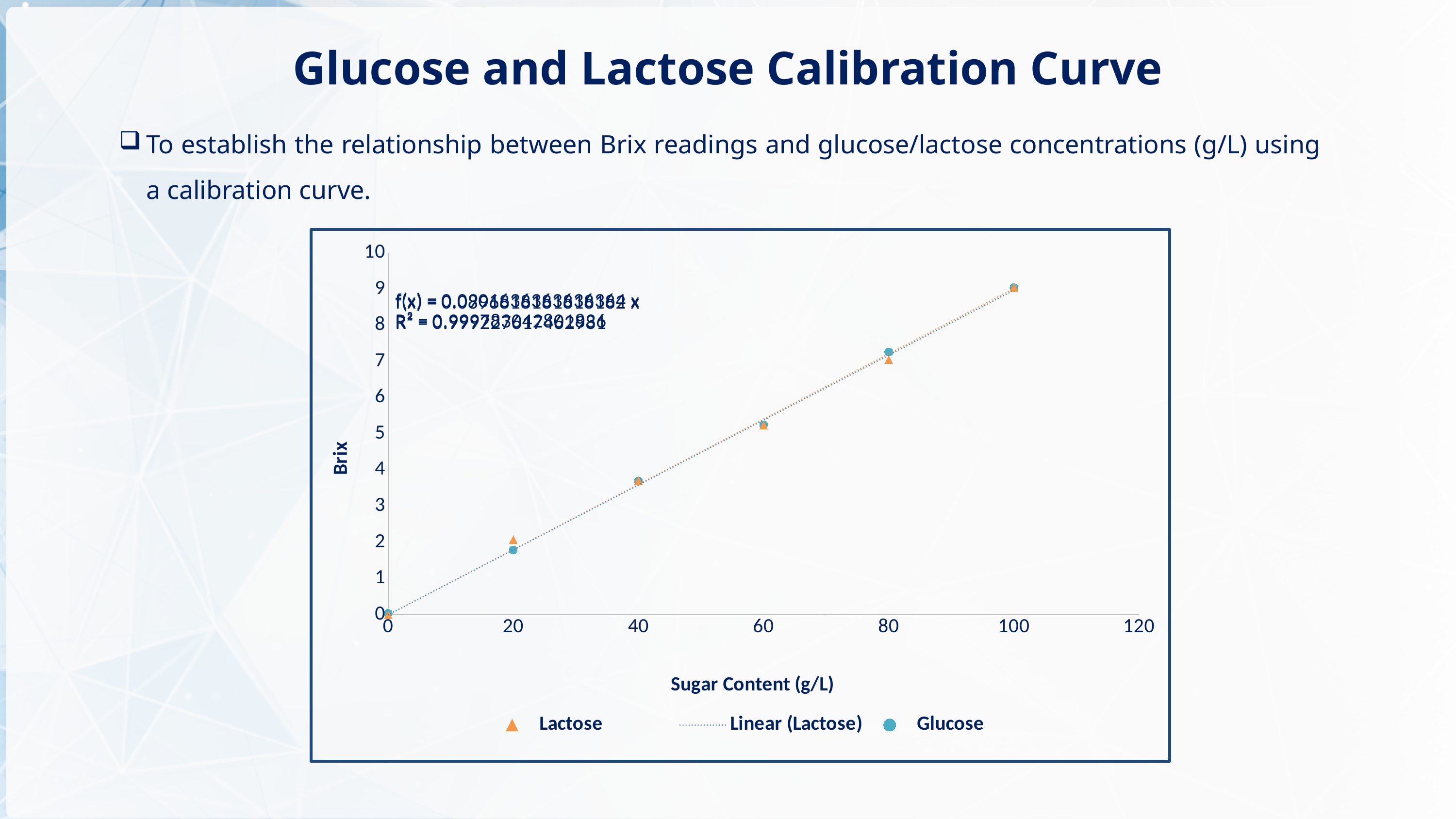
Is the Brix value for Glucose at 20 g/L greater or less than 2? less Is the Brix value for Glucose at 40 g/L greater or less than 3? greater Is the Brix value for Lactose at 60 g/L greater or less than 4? greater What is the title of the y axis? Brix What is the title of the x axis? Sugar Content (g/L) How many entries does the chart legend list? 3 Do the Brix values rise or fall as Sugar Content increases along the x axis? Rise What kind of chart is shown on the slide? Scatter chart At 20 g/L, which series has the higher Brix value, Lactose or Glucose? Lactose How many data points are plotted for the Glucose series? 6